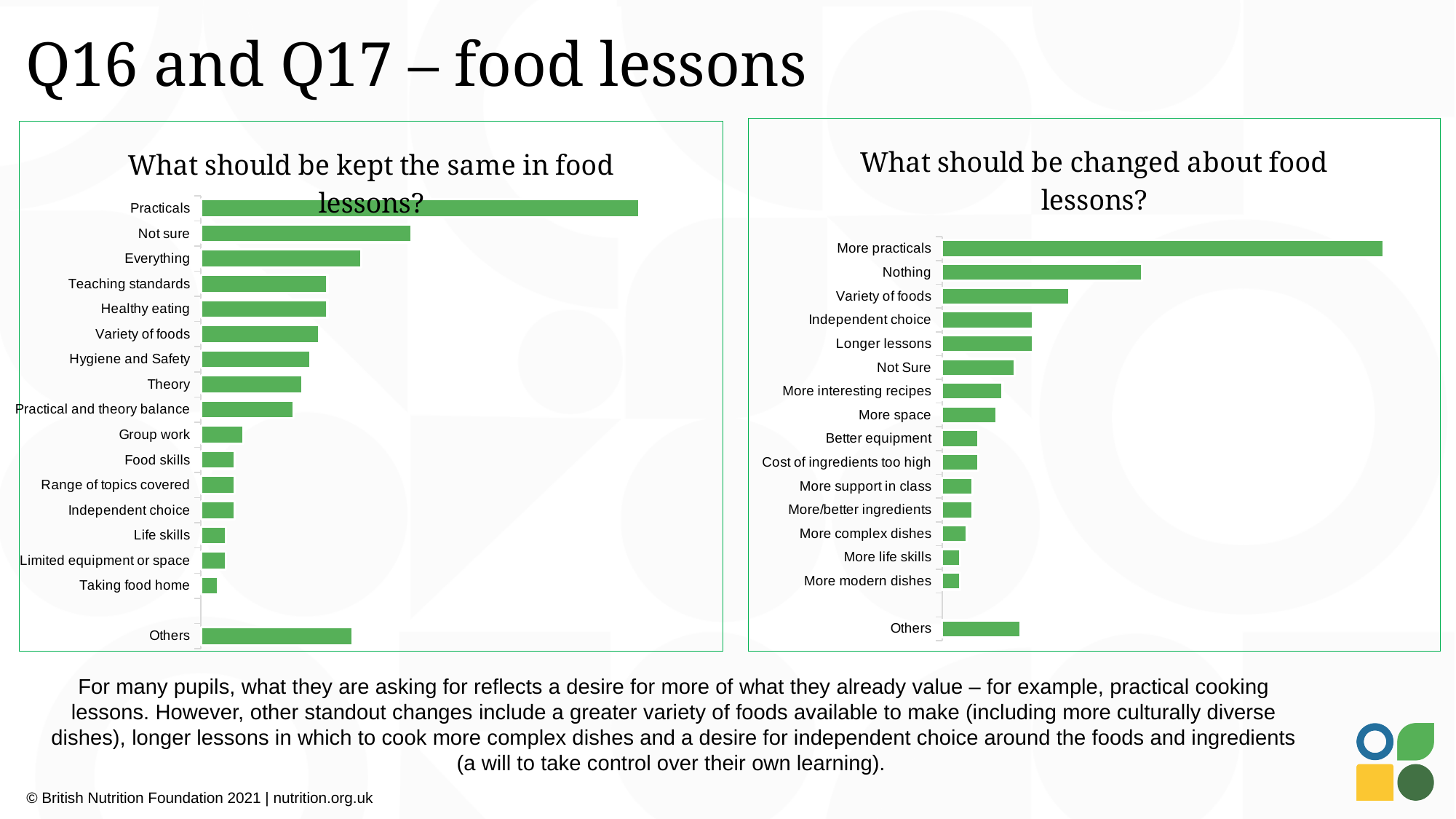
In the chart titled "What should be changed about food lessons?", which category has the longest bar? More practicals In the chart titled "What should be kept the same in food lessons?", which is larger: Not sure or Everything? Not sure What is the title of the chart on the left of the slide? What should be kept the same in food lessons? In the chart titled "What should be changed about food lessons?", which is larger: Not Sure or More space? Not Sure In the chart titled "What should be kept the same in food lessons?", which category has the shortest bar? Taking food home How many categories (including Others) are shown in the chart titled "What should be kept the same in food lessons?"? 17 In the chart titled "What should be changed about food lessons?", which is larger: Others or Better equipment? Others What kind of chart is the chart on the right of the slide? Bar chart In the chart titled "What should be kept the same in food lessons?", which category has the longest bar? Practicals How many categories (including Others) are shown in the chart titled "What should be changed about food lessons?"? 16